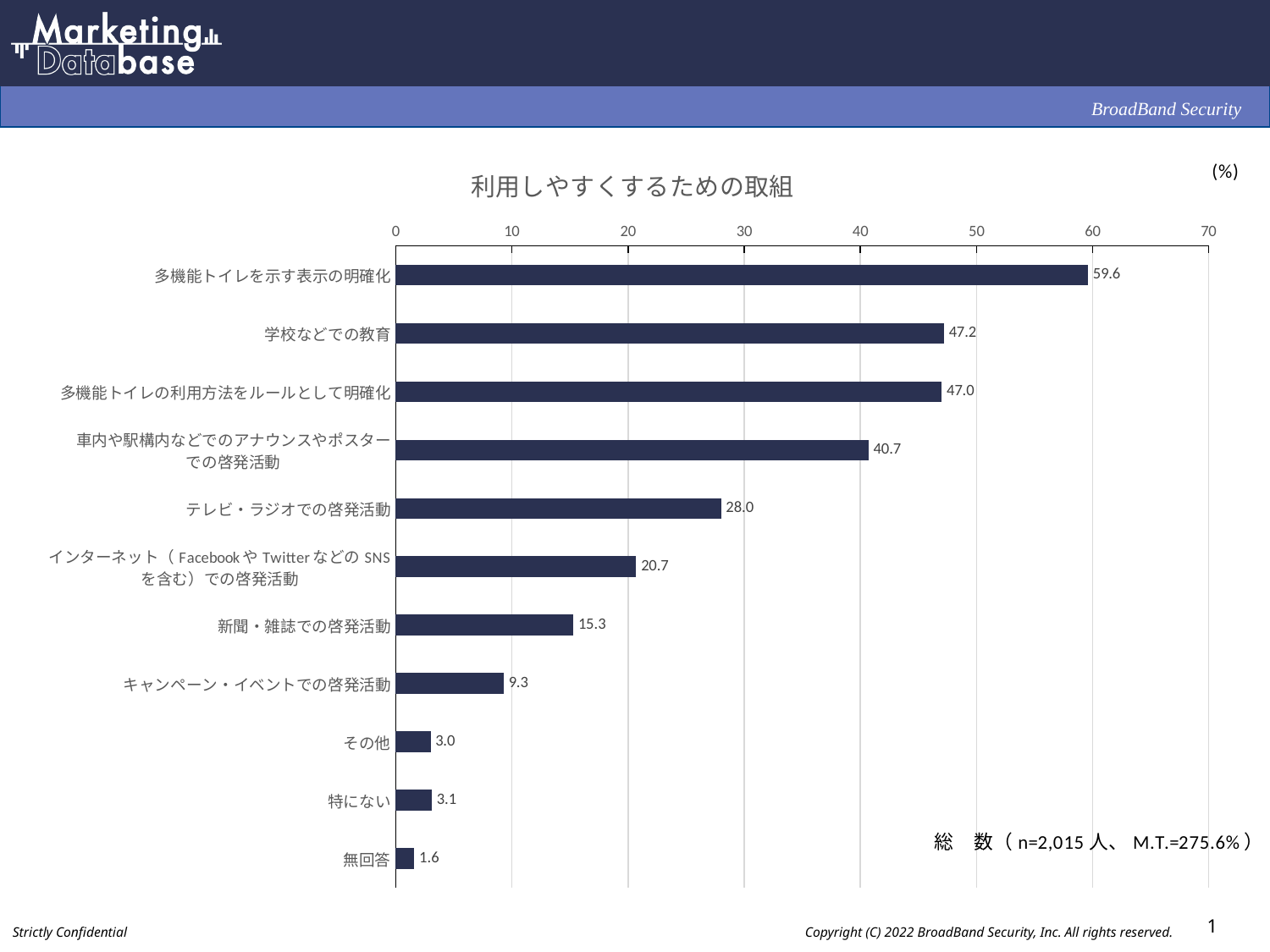
What is the value for 新聞・雑誌での啓発活動? 15.3 Which category has the lowest value? 無回答 Which is larger, the value for テレビ・ラジオでの啓発活動 or the value for 新聞・雑誌での啓発活動? テレビ・ラジオでの啓発活動 What is the value for 多機能トイレを示す表示の明確化? 59.6 Is the value for キャンペーン・イベントでの啓発活動 greater or less than 10? less What is the title of the chart? 利用しやすくするための取組 Which category has the highest value? 多機能トイレを示す表示の明確化 What is the difference between the values for 多機能トイレを示す表示の明確化 and 学校などでの教育? 12.4 What kind of chart is shown on the slide? bar chart How many categories are shown in the chart? 11 What is the value for 車内や駅構内などでのアナウンスやポスターでの啓発活動? 40.7 What is the value for 無回答? 1.6